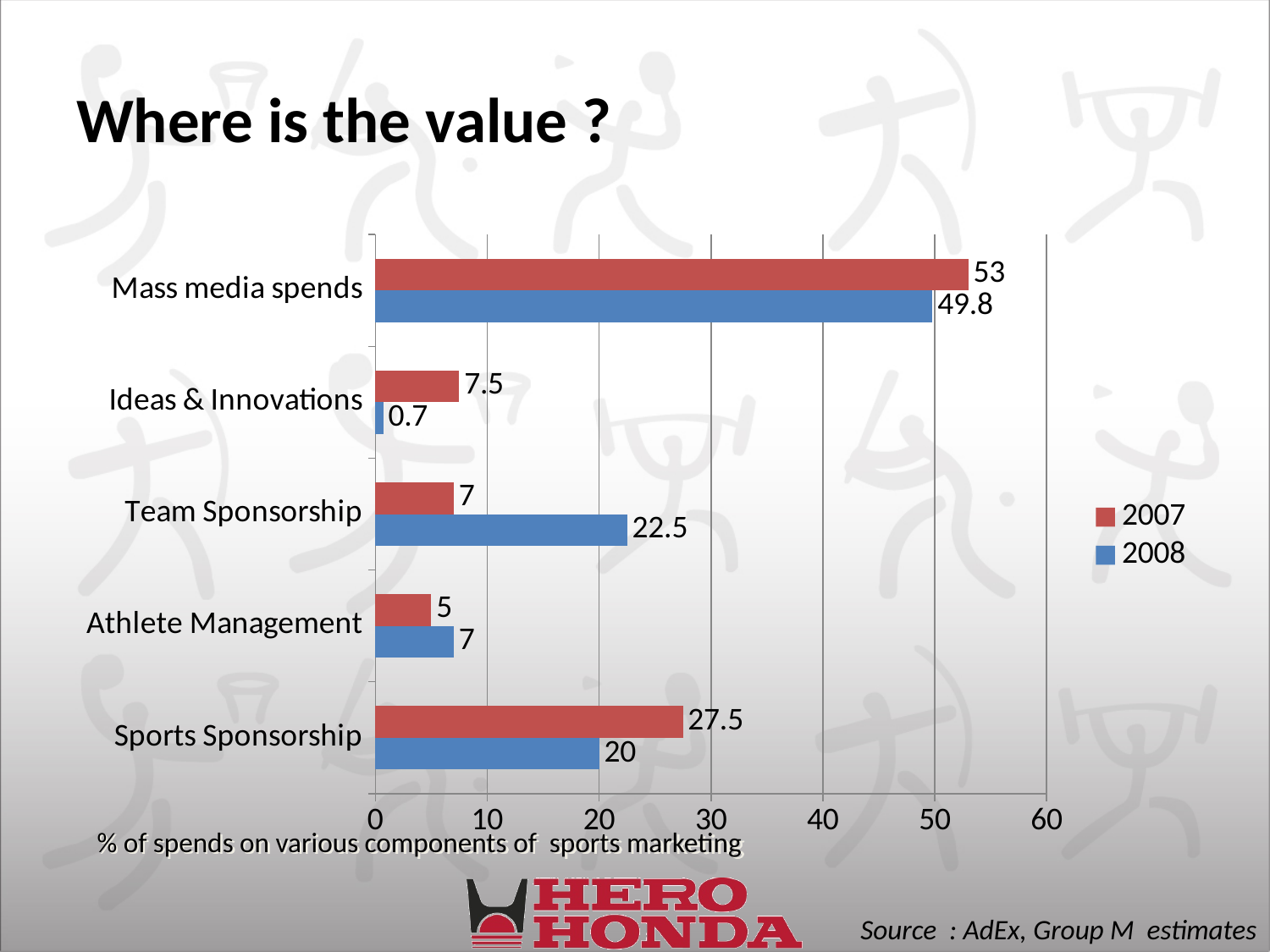
What is the 2008 value for Team Sponsorship? 22.5 What kind of chart is shown on the slide? Bar chart Which category has the highest 2008 value? Mass media spends How many categories are shown on the chart? 5 What is the difference between the 2007 and 2008 values for Mass media spends? 3.2 What is the 2007 value for Sports Sponsorship? 27.5 What is the 2007 value for Mass media spends? 53 How many series does the legend list? 2 Which is larger for Team Sponsorship, the 2007 value or the 2008 value? 2008 Which colour represents the 2008 series in the legend? Blue What is the 2008 value for Ideas & Innovations? 0.7 Which category has the lowest 2007 value? Athlete Management